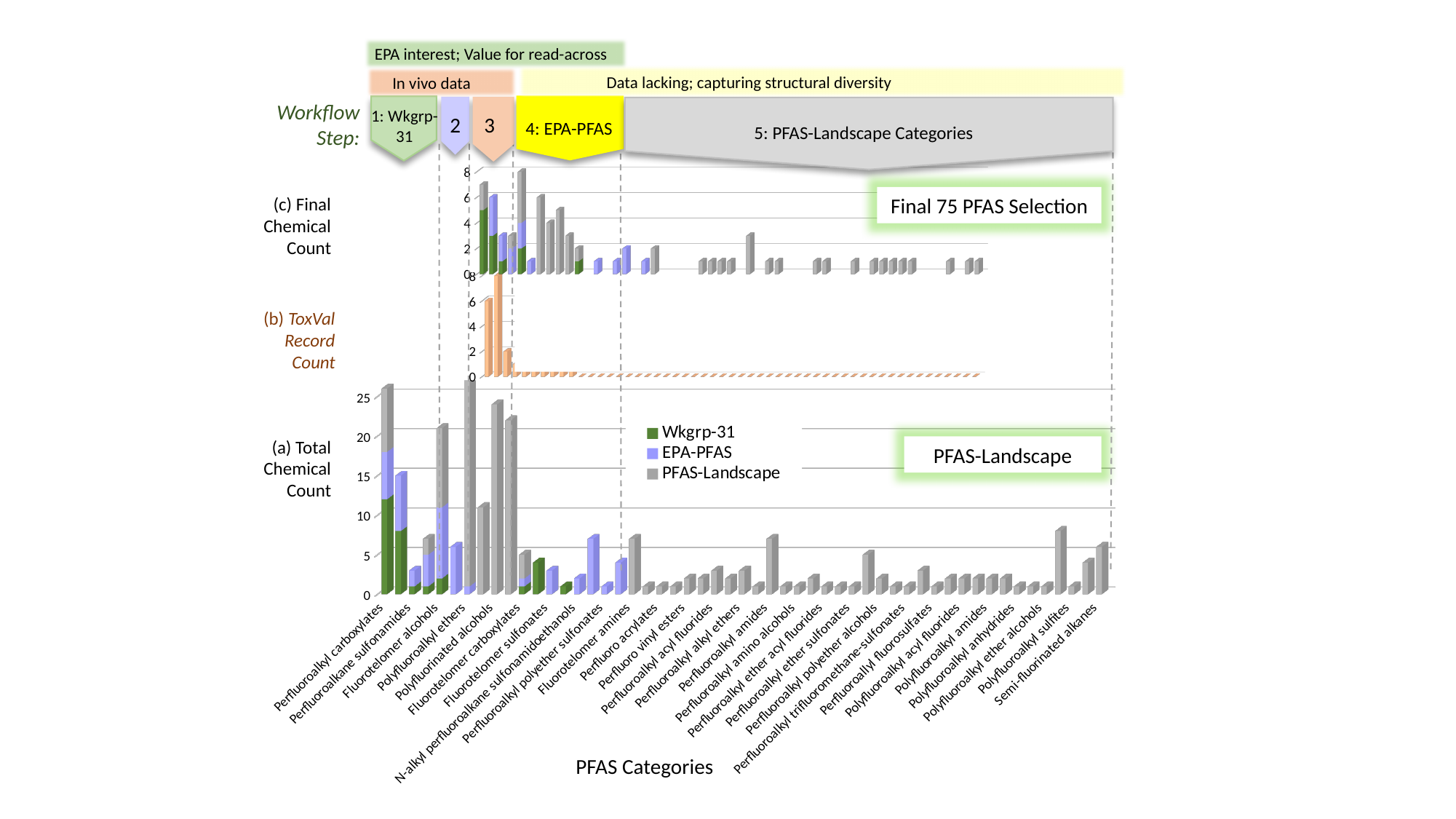
What is the x-axis title of chart (a) Total Chemical Count? PFAS Categories In chart (a) Total Chemical Count, which has the larger total: Perfluoroalkyl carboxylates or Perfluoroalkane sulfonamides? Perfluoroalkyl carboxylates In chart (c) Final Chemical Count, what is the highest value shown on the y axis? 8 What are the three series named in the legend? Wkgrp-31, EPA-PFAS, PFAS-Landscape In chart (a) Total Chemical Count, is the value for Polyfluoroalkyl sulfites greater or less than 5? less In chart (a) Total Chemical Count, is the total value for Perfluoroalkyl carboxylates greater or less than 25? greater In chart (a) Total Chemical Count, is the value for Perfluoro vinyl esters greater or less than 5? less How many series does the legend on the slide list? 3 In chart (a) Total Chemical Count, which has the larger total: Fluorotelomer carboxylates or Fluorotelomer sulfonates? Fluorotelomer carboxylates What kind of chart is chart (a) Total Chemical Count? bar chart